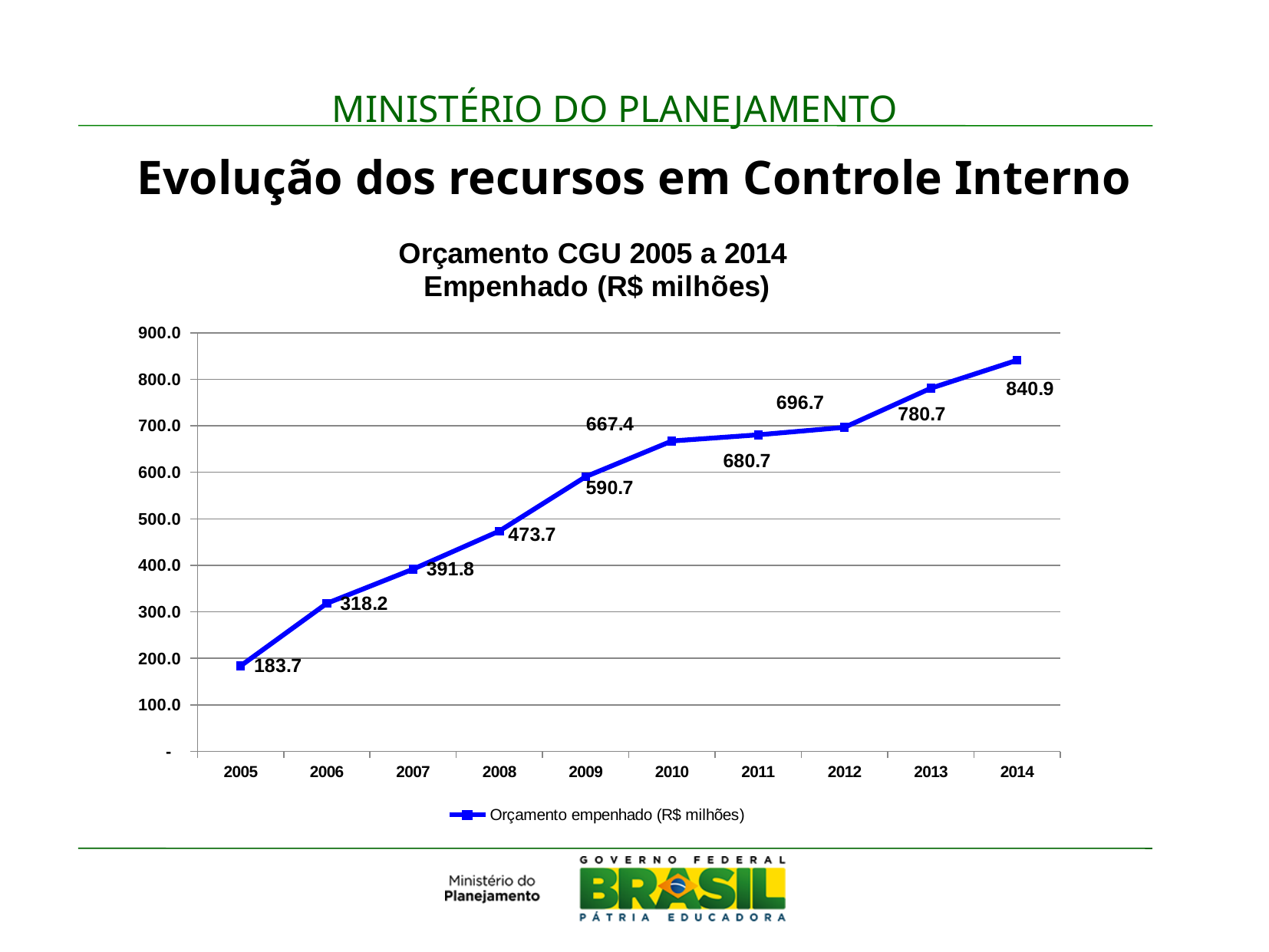
What is the value for 2005? 183.7 Which is larger, the value for 2011 or the value for 2012? 2012 What is the difference between the values for 2014 and 2013? 60.2 What kind of chart is this? line chart Which year has the lowest value? 2005 What is the difference between the values for 2009 and 2008? 117.0 What is the value for 2010? 667.4 Do the values rise or fall from 2005 to 2014? rise Is the value for 2007 greater or less than 400.0? less What is the value for 2014? 840.9 Which year has the highest value? 2014 How many years are plotted on the x axis? 10